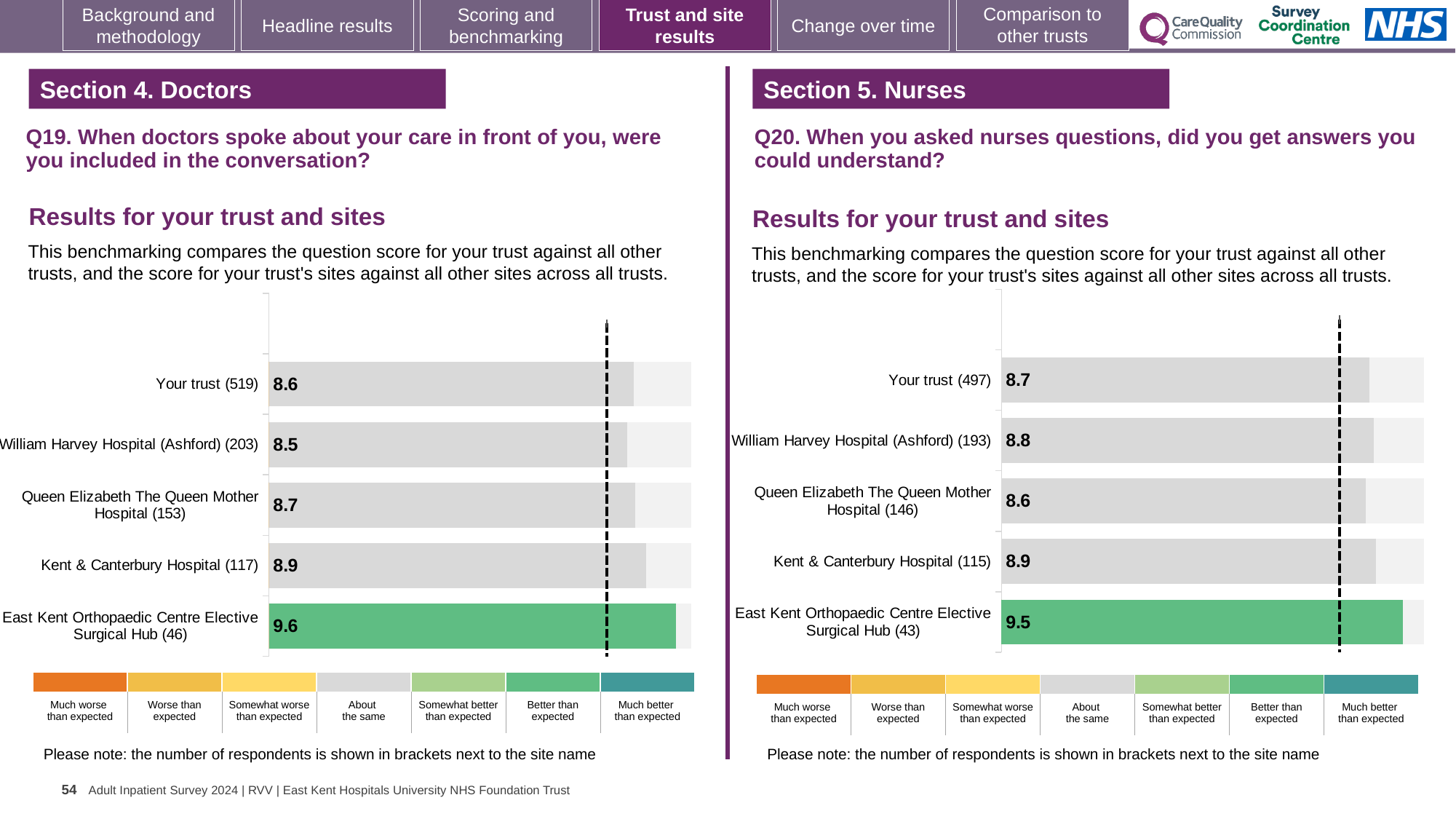
What kind of chart is used on the Q19 chart (left)? Bar chart On the Q19 chart (left), what is the score for Your trust? 8.6 On the Q20 chart (right), what is the score for William Harvey Hospital (Ashford)? 8.8 On the Q20 chart (right), what is the score for Queen Elizabeth The Queen Mother Hospital? 8.6 On the Q19 chart (left), what is the difference between the scores for East Kent Orthopaedic Centre Elective Surgical Hub and Your trust? 1.0 On the Q20 chart (right), which is larger: the score for Kent & Canterbury Hospital or the score for Your trust? Kent & Canterbury Hospital On the Q20 chart (right), what is the difference between the scores for East Kent Orthopaedic Centre Elective Surgical Hub and Queen Elizabeth The Queen Mother Hospital? 0.9 On the Q19 chart (left), which site has the lowest score? William Harvey Hospital (Ashford) On the Q19 chart (left), what is the score for Kent & Canterbury Hospital? 8.9 On the Q19 chart (left), which site has the highest score? East Kent Orthopaedic Centre Elective Surgical Hub On the Q19 chart (left), how many bars are plotted? 5 On the Q20 chart (right), which site has the highest score? East Kent Orthopaedic Centre Elective Surgical Hub